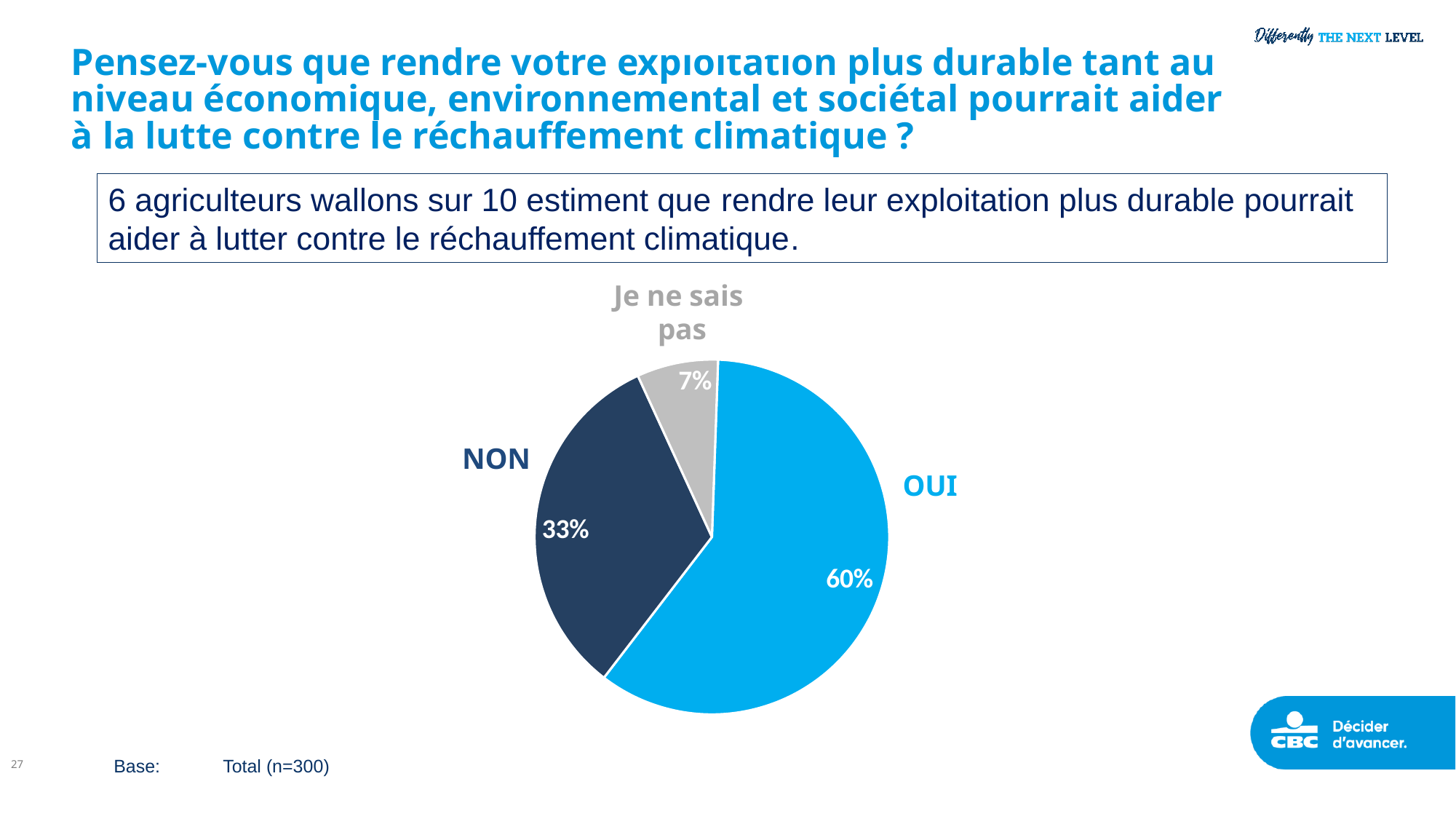
What colour is the OUI slice? Light blue What is the difference in percentage points between OUI and NON? 27 What is the difference in percentage points between NON and 'Je ne sais pas'? 26 How many slices does the pie chart have? 3 Which response has the largest share of the pie? OUI What percentage of respondents answered OUI? 60% Which response has the smallest share of the pie? Je ne sais pas Which is larger, the share for NON or the share for 'Je ne sais pas'? NON What kind of chart is shown on the slide? Pie chart What is the base (sample size) stated for the chart? Total (n=300) What percentage of respondents answered 'Je ne sais pas'? 7% What percentage of respondents answered NON? 33%